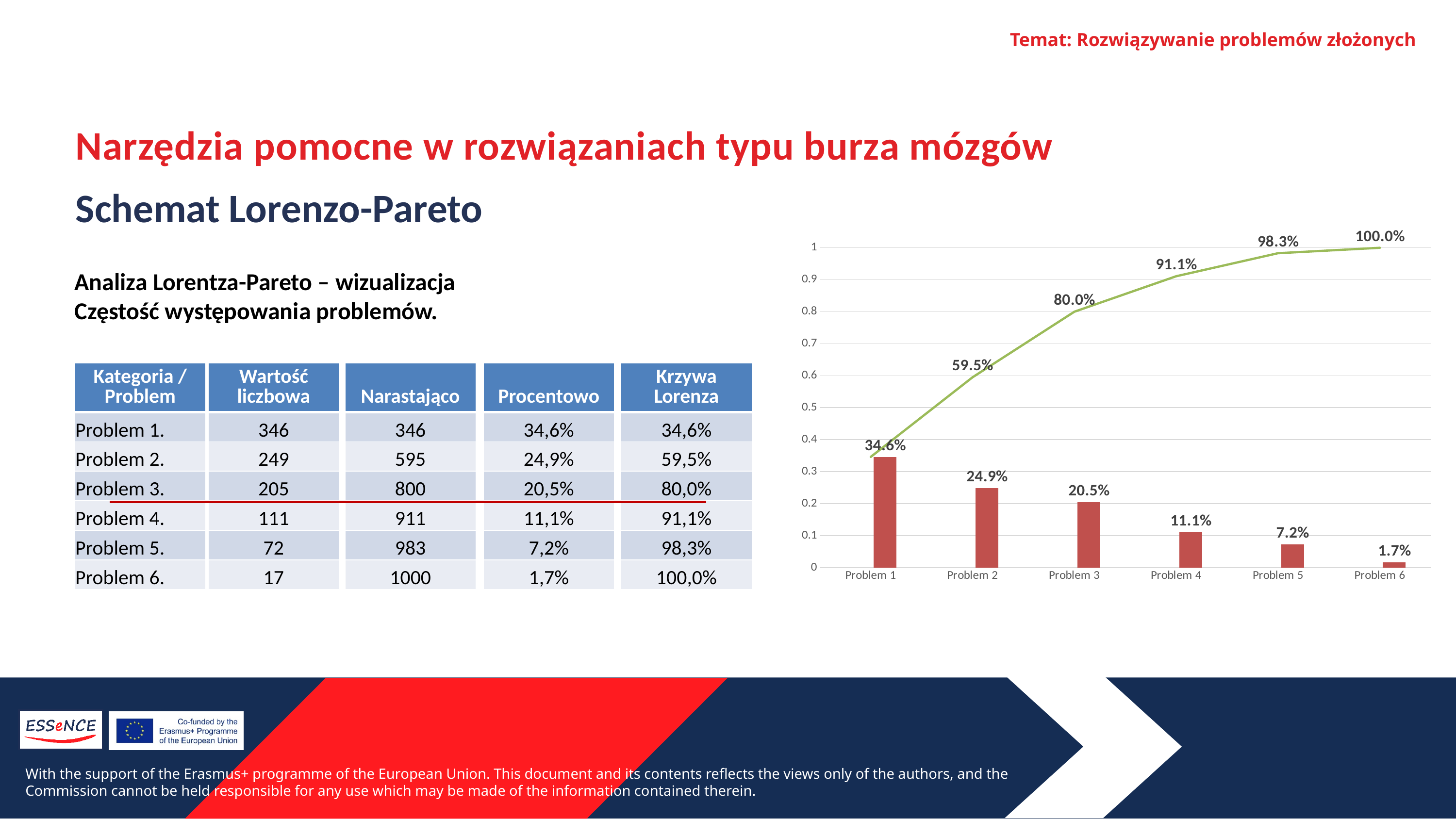
What is the bar value for Problem 1? 34.6% Is the bar value for Problem 1 greater or less than 0.3 on the axis? greater What is the difference between the bar values for Problem 2 and Problem 3? 4.4% Which problem has the lowest bar value? Problem 6 What kind of chart is shown on the slide? Bar chart with a cumulative line What is the cumulative line value at Problem 5? 98.3% How many problems are shown on the x axis of the chart? 6 What is the cumulative line value at Problem 3? 80.0% Which problem has the highest bar value? Problem 1 Which has a larger bar value, Problem 4 or Problem 5? Problem 4 What is the bar value for Problem 4? 11.1% Do the bar values rise or fall from Problem 1 to Problem 6? fall